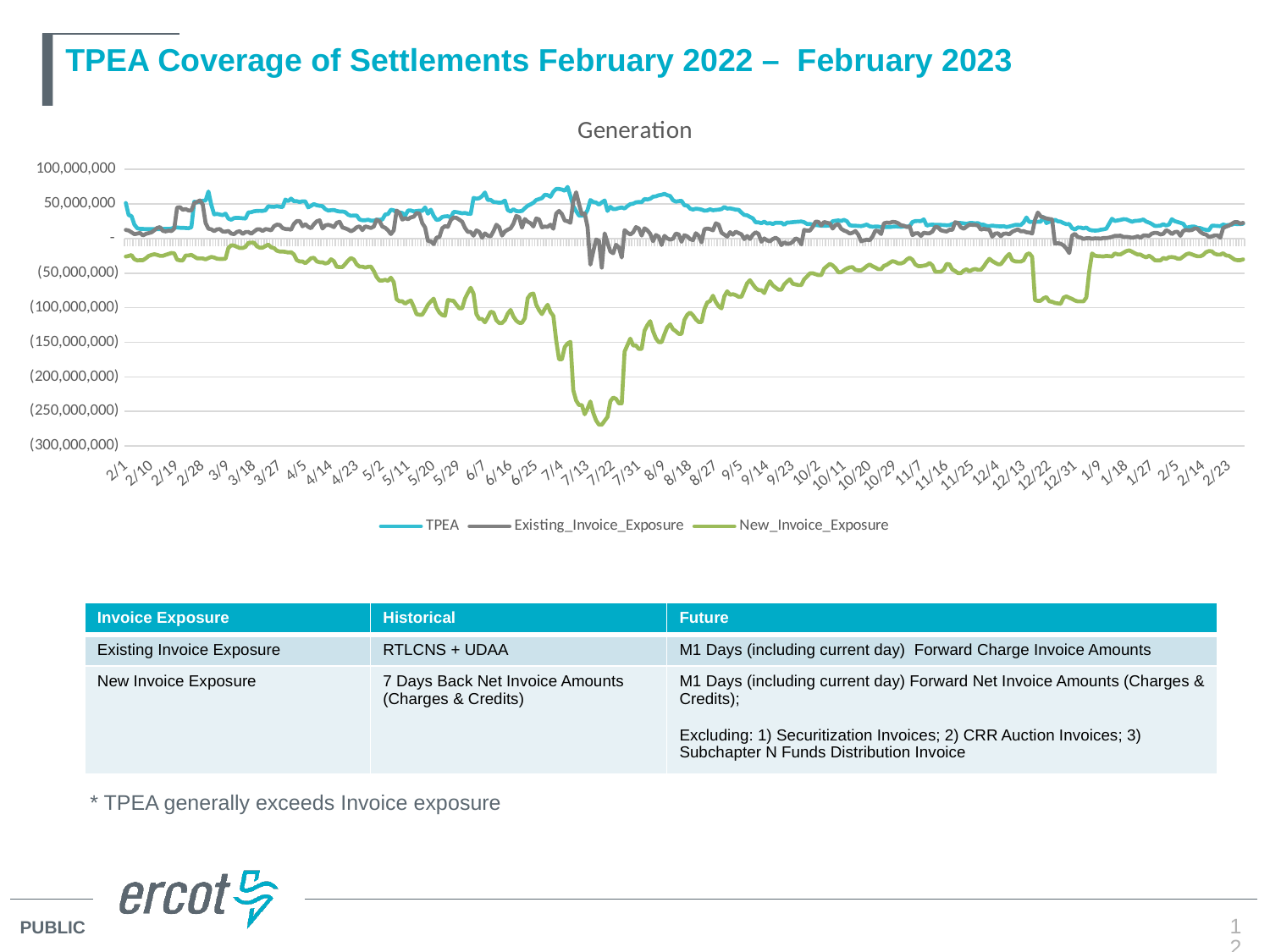
Is the value of New_Invoice_Exposure around 12/22 greater or less than (50,000,000)? less Is the value of TPEA around 2/23 greater or less than 50,000,000? less Is the value of New_Invoice_Exposure around 7/13 greater or less than (200,000,000)? less Does New_Invoice_Exposure rise or fall between 7/13 and 10/2? rise Which series is generally the highest across the chart? TPEA What kind of chart is shown on the slide? line chart What is the title of the chart? Generation How many series does the chart legend list? 3 Around 7/13, which series has the higher value, TPEA or New_Invoice_Exposure? TPEA Which series reaches the lowest value on the chart? New_Invoice_Exposure What are the three series named in the chart legend? TPEA, Existing_Invoice_Exposure, New_Invoice_Exposure